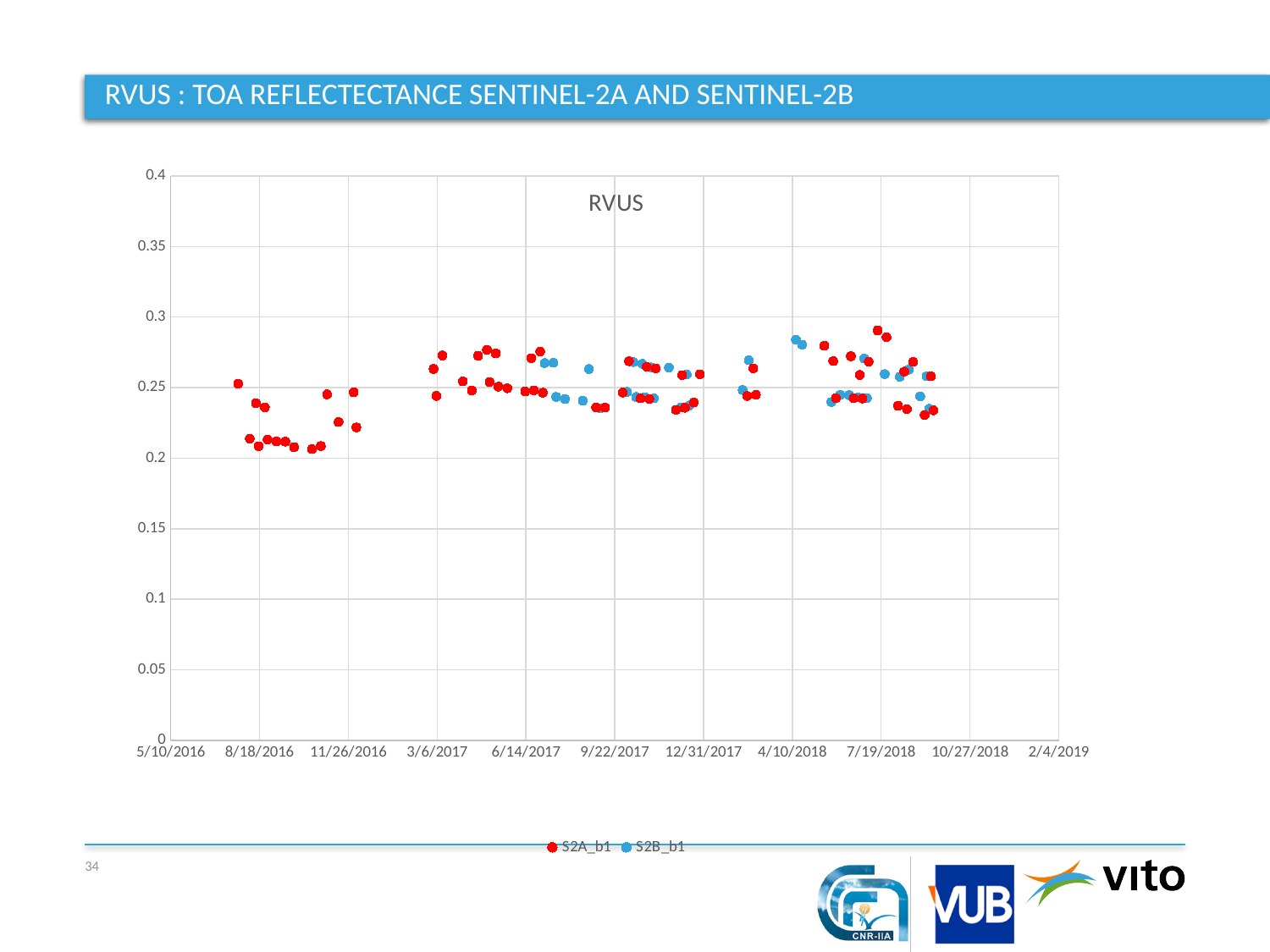
Which series has data points in 2016, before any points of the other series appear? S2A_b1 Are all plotted values in the chart greater or less than 0.15? greater Which series contains the lowest plotted values in the chart? S2A_b1 Are all plotted values in the chart greater or less than 0.3? less What is the first date label on the x axis? 5/10/2016 How many series does the legend list? 2 What is the title shown inside the chart area? RVUS What are the names of the two series in the legend? S2A_b1 and S2B_b1 Is the lowest plotted value in the chart greater or less than 0.25? less What kind of chart is shown on the slide? scatter chart What is the maximum value shown on the y axis? 0.4 What is the last date label on the x axis? 2/4/2019